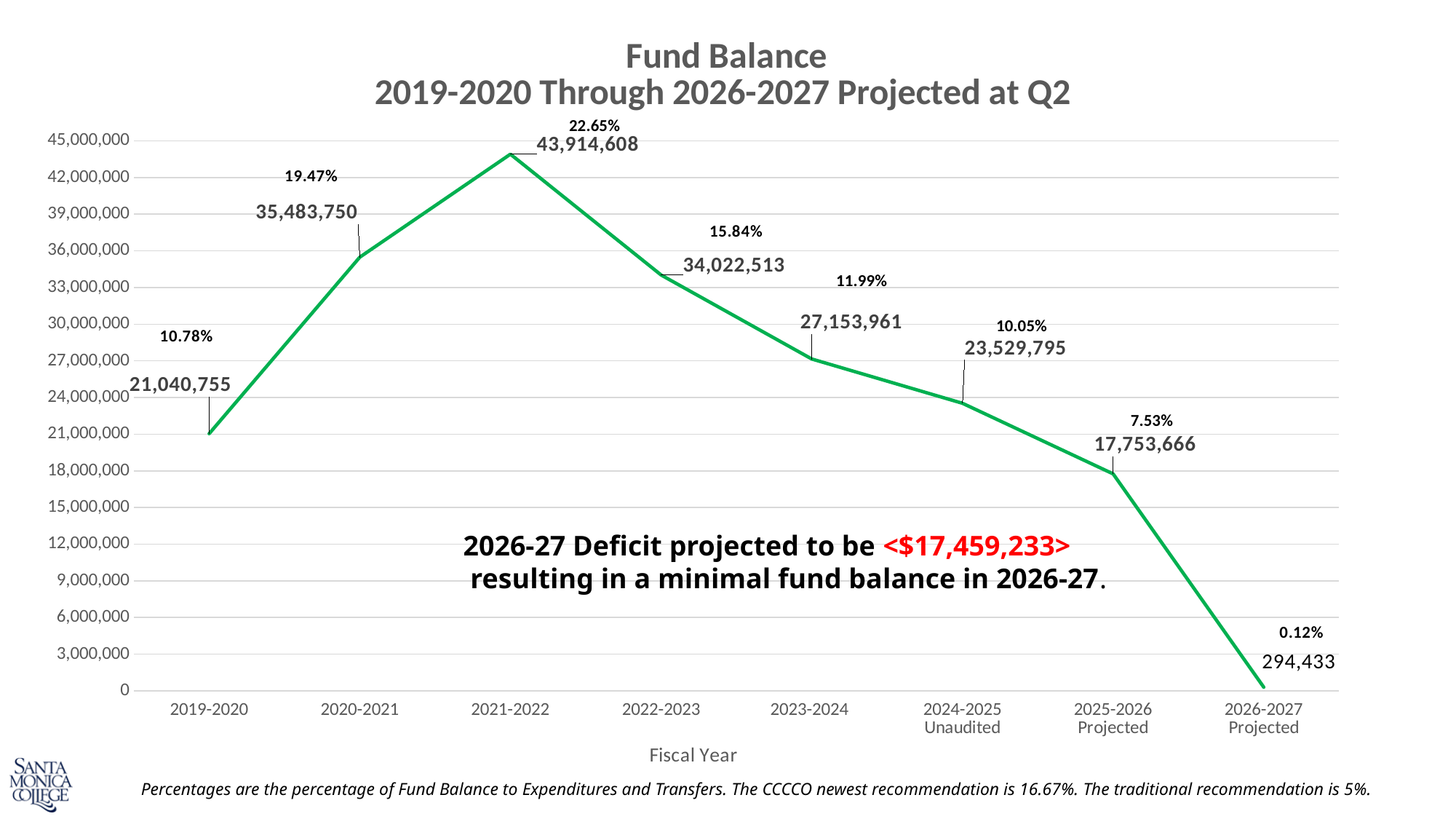
How many fiscal years are plotted on the chart? 8 Which is larger, the fund balance for 2019-2020 or for 2023-2024? 2023-2024 What is the fund balance for 2026-2027 Projected? 294,433 What is the difference between the fund balance in 2025-2026 Projected and 2026-2027 Projected? 17,459,233 What is the fund balance for 2021-2022? 43,914,608 What kind of chart is shown on the slide? Line chart Which fiscal year has the highest fund balance? 2021-2022 Which fiscal year has the lowest fund balance? 2026-2027 Projected What is the fund balance for 2024-2025 Unaudited? 23,529,795 What is the difference between the fund balance in 2021-2022 and 2020-2021? 8,430,858 Does the fund balance rise or fall from 2021-2022 to 2026-2027 Projected? Fall What percentage is shown for 2025-2026 Projected? 7.53%